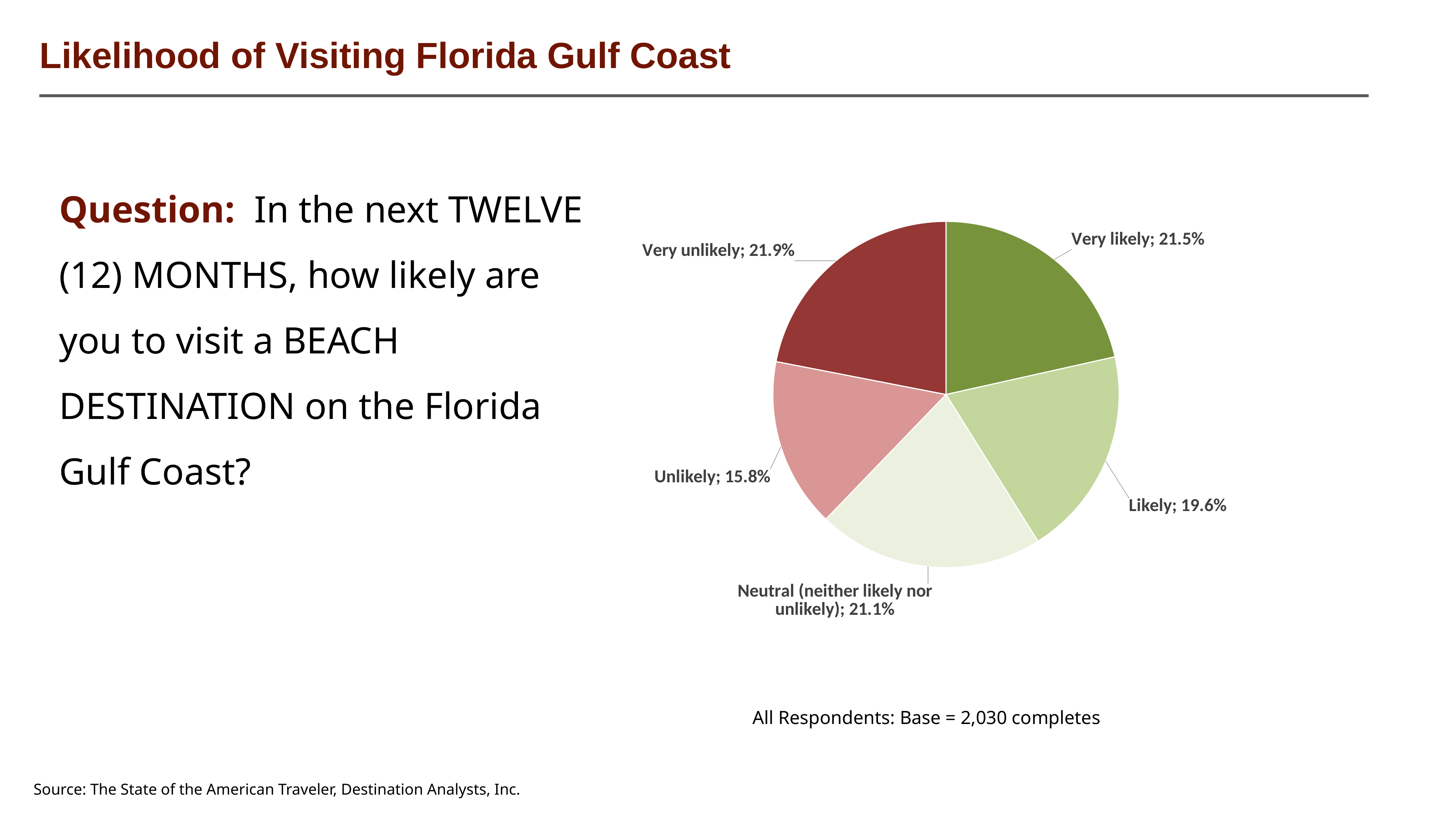
How many response categories are shown in the pie chart? 5 What type of chart is shown on the slide? Pie chart What is the combined share of respondents who answered Very likely or Likely? 41.1% What percentage of respondents answered Unlikely? 15.8% What is the base number of completes stated below the chart? 2,030 What is the difference in percentage points between Very unlikely and Unlikely? 6.1 What share of respondents were Neutral (neither likely nor unlikely)? 21.1% Which response category has the smallest share of the pie? Unlikely What percentage of respondents said Likely? 19.6% What percentage of respondents said they are very likely to visit a beach destination on the Florida Gulf Coast? 21.5% Which is larger, the share for Likely or the share for Unlikely? Likely Which response category has the largest share of the pie? Very unlikely